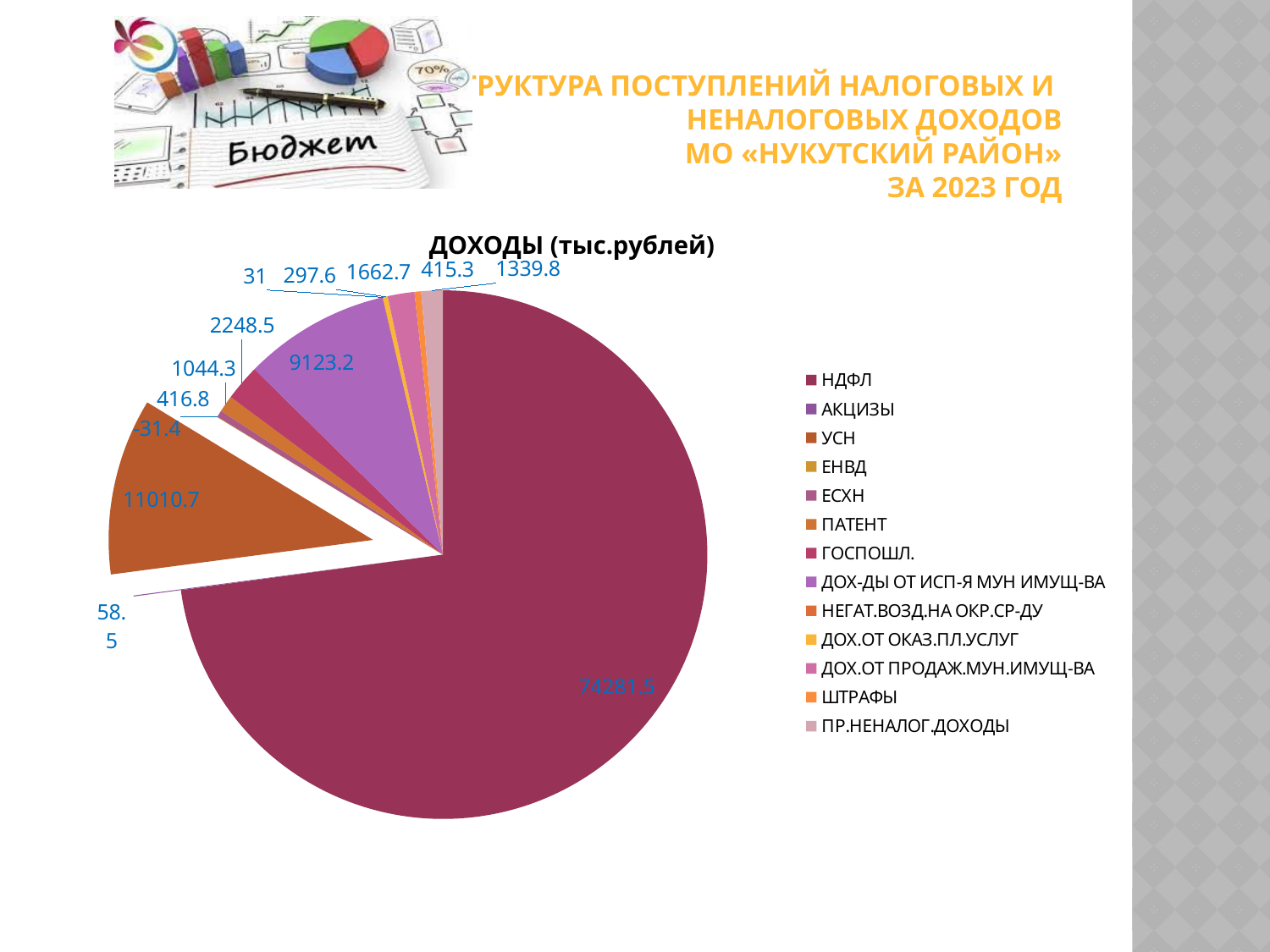
What is the value shown for ДОХ-ДЫ ОТ ИСП-Я МУН ИМУЩ-ВА? 9123.2 What is the title of the chart? ДОХОДЫ (тыс.рублей) What is the value shown for НДФЛ? 74281.5 What is the largest value printed on the pie chart? 74281.5 What is the difference between the values for НДФЛ and УСН? 63270.8 How many categories does the legend of the pie chart list? 13 Which category has the largest slice of the pie? НДФЛ What is the smallest value printed on the pie chart? -31.4 What kind of chart is shown on the slide? pie chart What is the difference between the values for УСН and ДОХ-ДЫ ОТ ИСП-Я МУН ИМУЩ-ВА? 1887.5 Which is larger, the value for НДФЛ or the value for УСН? НДФЛ What is the value shown for УСН? 11010.7